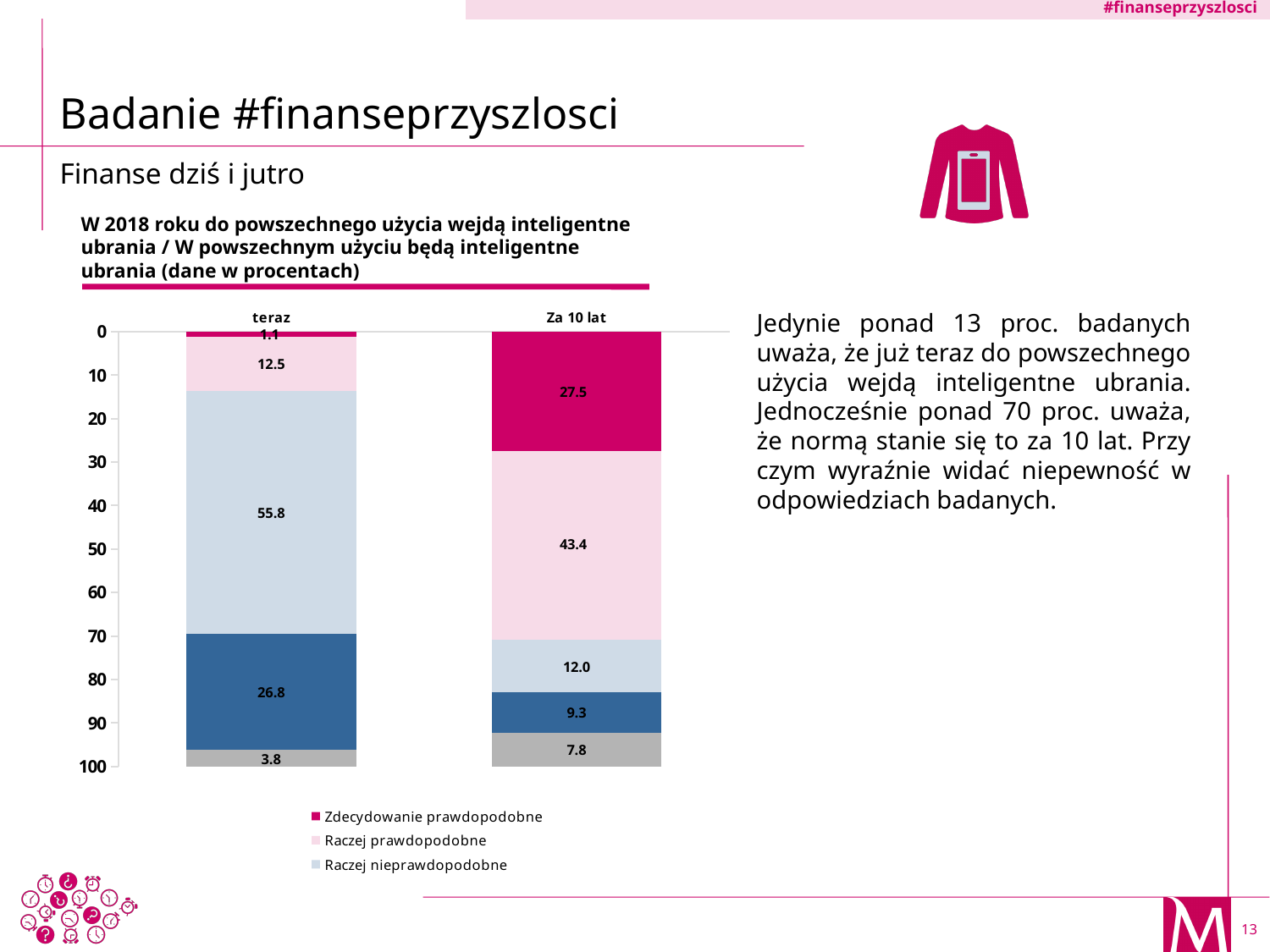
Which is larger: the "Raczej nieprawdopodobne" value for "teraz" or for "Za 10 lat"? teraz What is the difference between the "Zdecydowanie prawdopodobne" values for "Za 10 lat" and "teraz"? 26.4 What is the value of the "Raczej prawdopodobne" segment for "Za 10 lat"? 43.4 What is the value of the "Zdecydowanie prawdopodobne" segment for "teraz"? 1.1 What is the value of the "Raczej nieprawdopodobne" segment for "teraz"? 55.8 Which segment is the largest in the "teraz" bar? Raczej nieprawdopodobne What is the total of the "Za 10 lat" stacked bar? 100.0 What is the value of the "Zdecydowanie prawdopodobne" segment for "Za 10 lat"? 27.5 How many bars (categories) does the chart show? 2 What kind of chart is shown on the slide? Stacked bar chart How many series does the legend list? 3 Which segment is the largest in the "Za 10 lat" bar? Raczej prawdopodobne